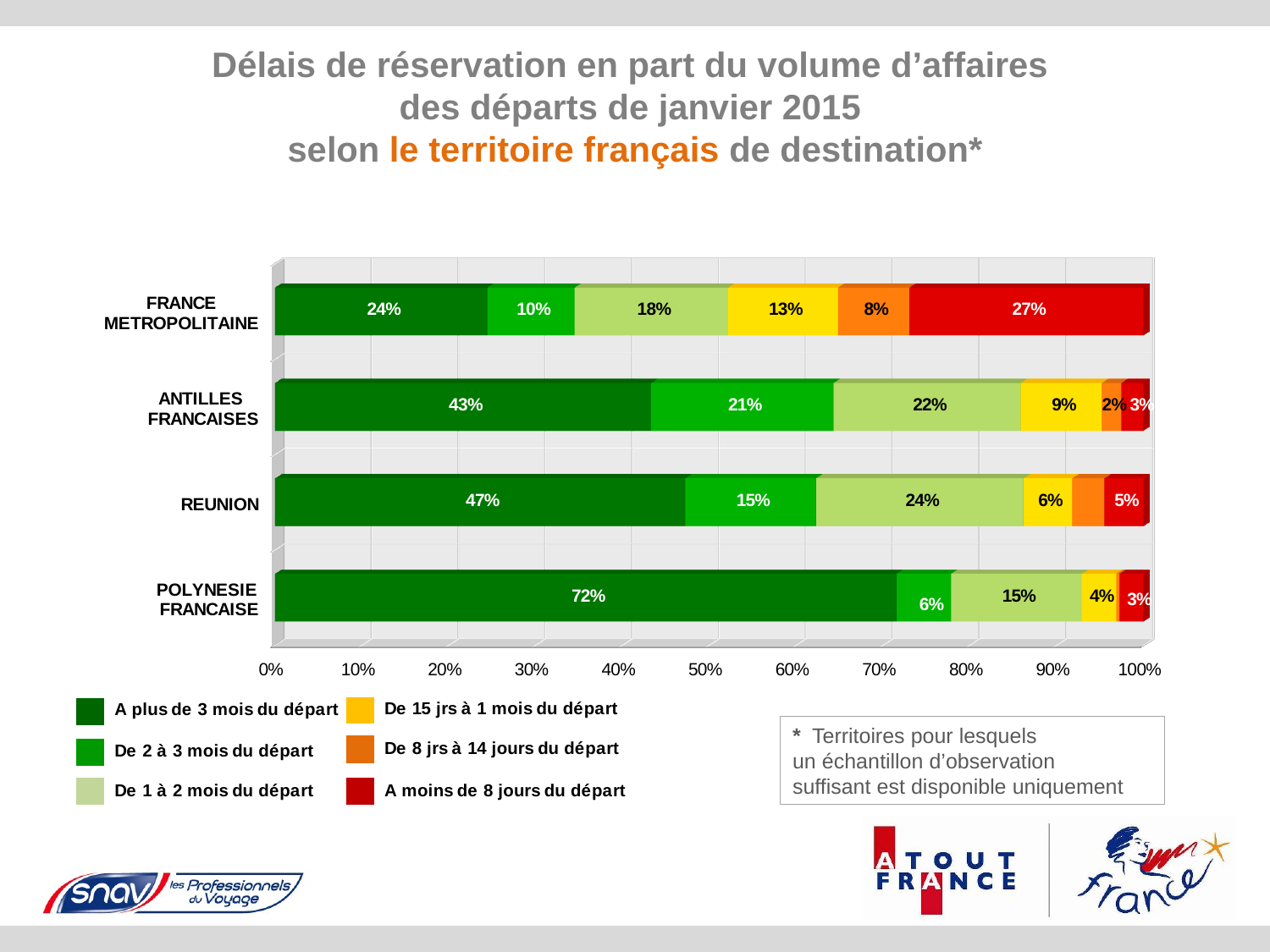
What is the value of 'A plus de 3 mois du départ' for POLYNESIE FRANCAISE? 72% What is the difference between the 'A plus de 3 mois du départ' values for REUNION and ANTILLES FRANCAISES? 4% What is the value of 'De 1 à 2 mois du départ' for REUNION? 24% Which is larger: the 'A moins de 8 jours du départ' value for FRANCE METROPOLITAINE or for REUNION? FRANCE METROPOLITAINE How many series does the legend list? 6 Which territory has the lowest share for 'A plus de 3 mois du départ'? FRANCE METROPOLITAINE What is the value of 'De 2 à 3 mois du départ' for ANTILLES FRANCAISES? 21% Which legend entry is shown in red? A moins de 8 jours du départ What is the value of 'A moins de 8 jours du départ' for FRANCE METROPOLITAINE? 27% How many territories (categories) are shown on the chart? 4 What type of chart is shown on the slide? Stacked bar chart Which territory has the highest share for 'A plus de 3 mois du départ'? POLYNESIE FRANCAISE